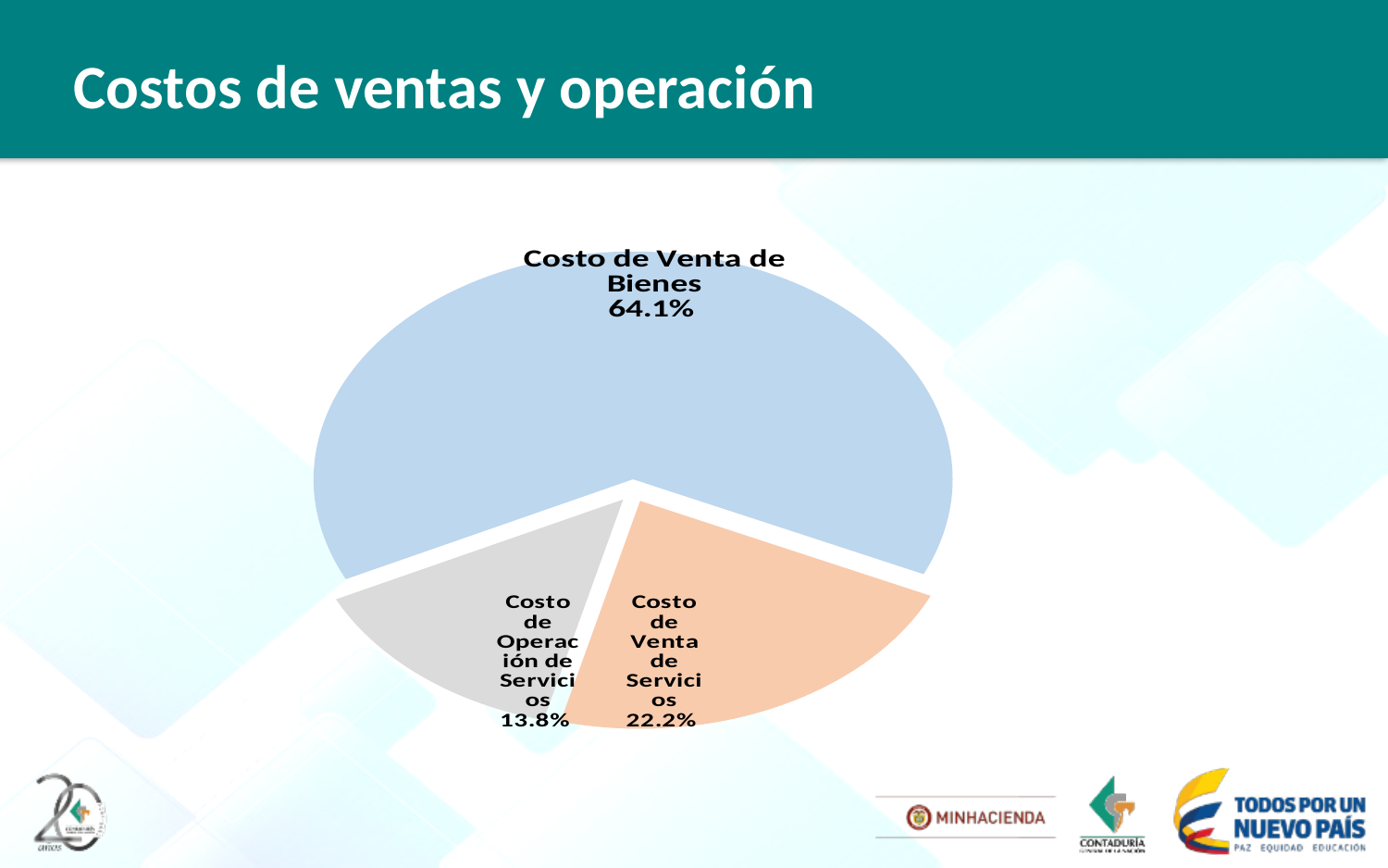
What colour is the Costo de Venta de Bienes slice in the pie chart? light blue What share does Costo de Operación de Servicios have in the pie chart? 13.8% Which slice of the pie chart is the largest? Costo de Venta de Bienes What is the difference in percentage points between Costo de Venta de Servicios and Costo de Operación de Servicios? 8.4 What is the title of the slide containing the pie chart? Costos de ventas y operación Which is larger, Costo de Venta de Servicios or Costo de Operación de Servicios? Costo de Venta de Servicios What is the difference in percentage points between Costo de Venta de Bienes and Costo de Venta de Servicios? 41.9 What kind of chart is shown on the slide? pie chart How many slices does the pie chart have? 3 Which slice of the pie chart is the smallest? Costo de Operación de Servicios What share does Costo de Venta de Bienes have in the pie chart? 64.1% What share does Costo de Venta de Servicios have in the pie chart? 22.2%